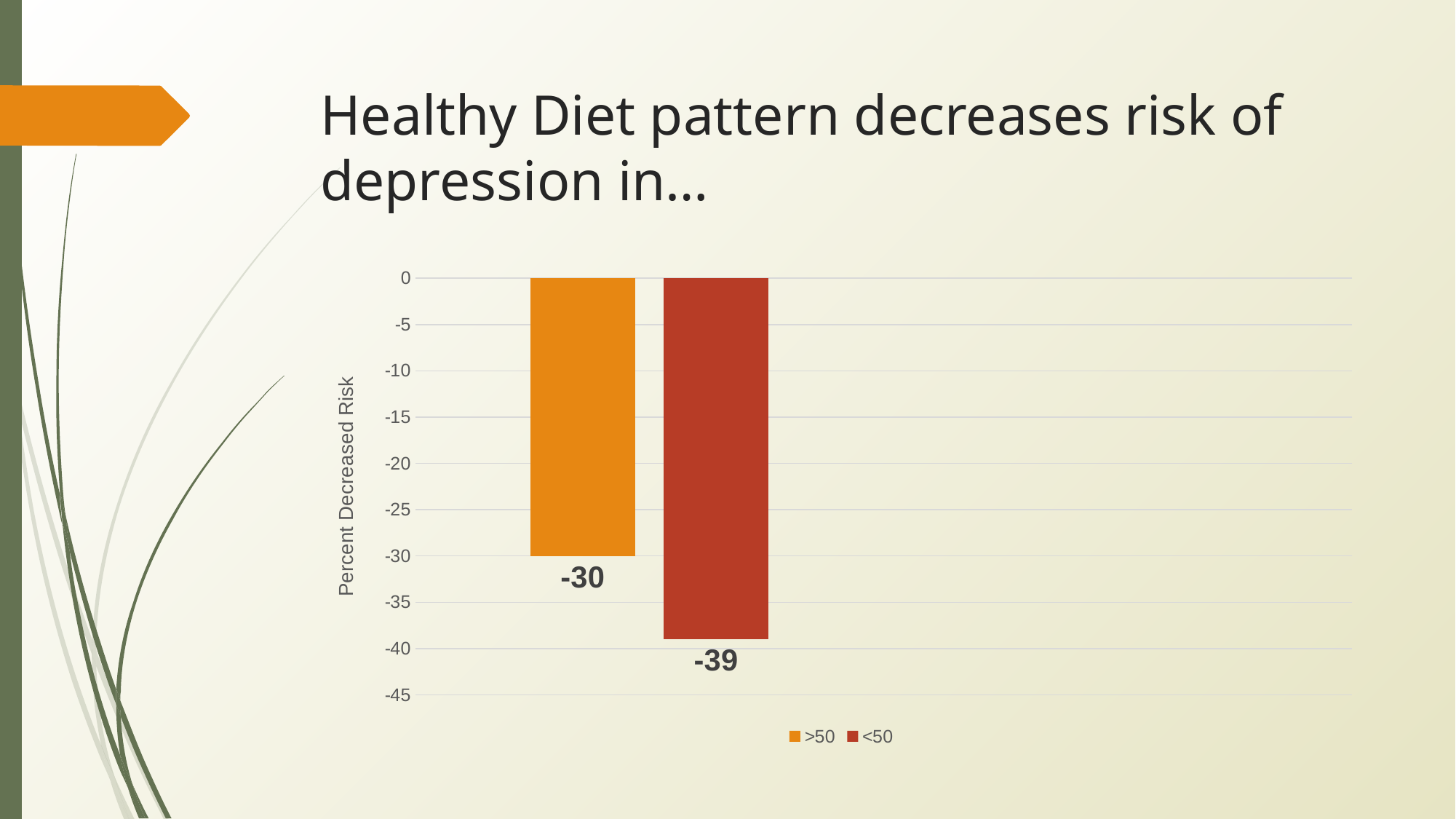
How many series does the legend list? 2 How many bars are plotted in the chart? 2 What is the difference between the values for >50 and <50? 9 What is the value for the >50 series? -30 What colour is the bar for the <50 series? Red What is the label of the vertical axis? Percent Decreased Risk Which series shows the larger decrease in risk, >50 or <50? <50 Which series has the highest (least negative) value? >50 Which series has the lowest (most negative) value? <50 What is the value for the <50 series? -39 Is the value for <50 greater or less than -35? less What kind of chart is shown on the slide? Bar chart